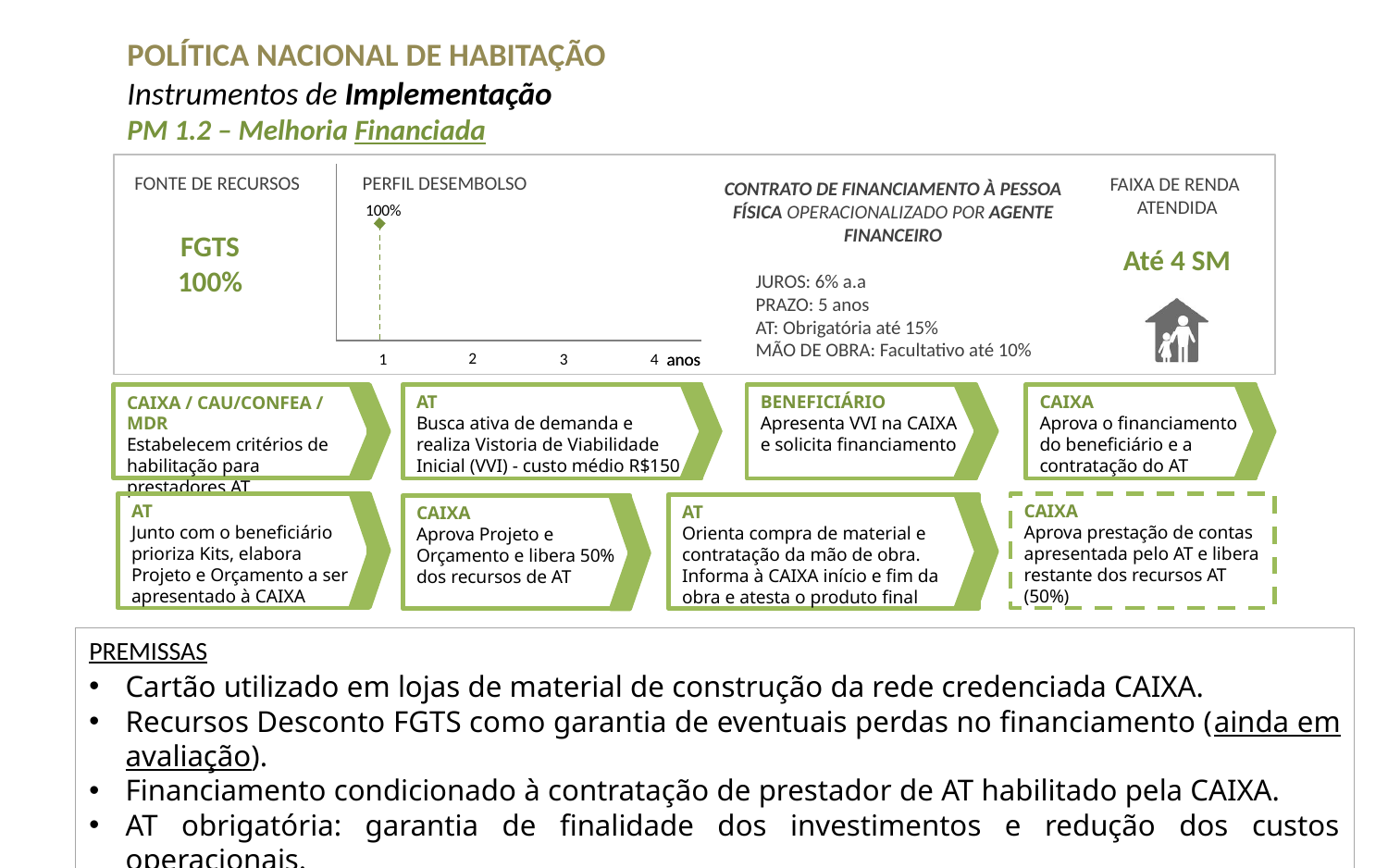
In the PERFIL DESEMBOLSO chart, at which year is the single data point plotted? 1 What unit is written at the end of the x axis of the PERFIL DESEMBOLSO chart? anos In the PERFIL DESEMBOLSO chart, how many year ticks are shown on the x axis? 4 In the PERFIL DESEMBOLSO chart, how many data points are plotted? 1 In the PERFIL DESEMBOLSO chart, what value is labelled at year 1? 100% What is the title of the chart on the slide? PERFIL DESEMBOLSO